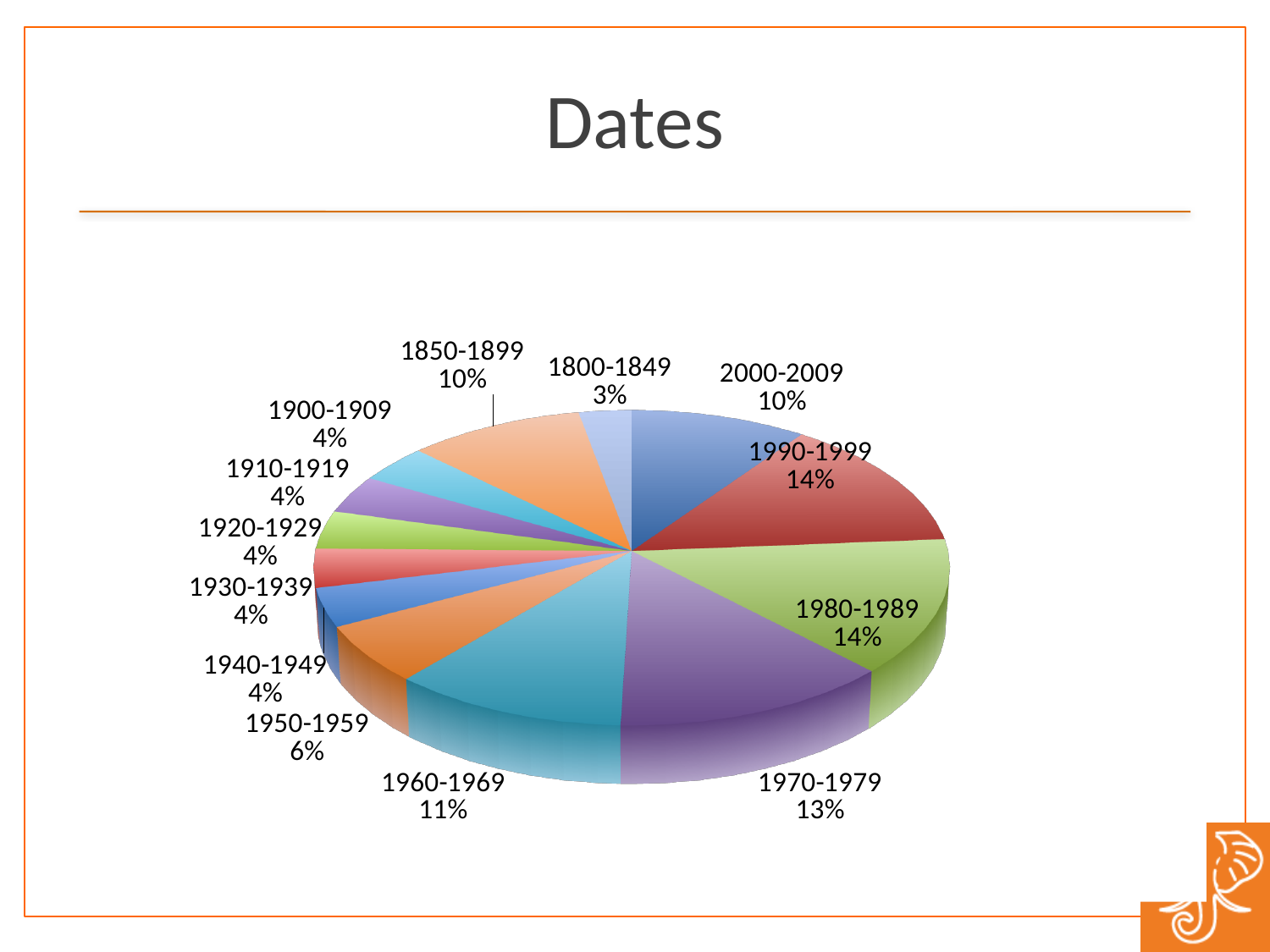
How many periods (slices) are shown in the pie chart? 13 Which is larger, the share for 1990-1999 or the share for 1970-1979? 1990-1999 What is the value for 1950-1959? 6% What share of the pie does 1970-1979 represent? 13% What percentage is shown for 1850-1899? 10% What is the difference between the values for 1970-1979 and 2000-2009? 3% What kind of chart is shown on the slide? Pie chart Which is larger, the share for 1960-1969 or the share for 1850-1899? 1960-1969 Which period has the smallest slice of the pie? 1800-1849 What is the difference between the shares for 1980-1989 and 1950-1959? 8% What is the title of the slide containing the chart? Dates What is the value shown for 1960-1969? 11%